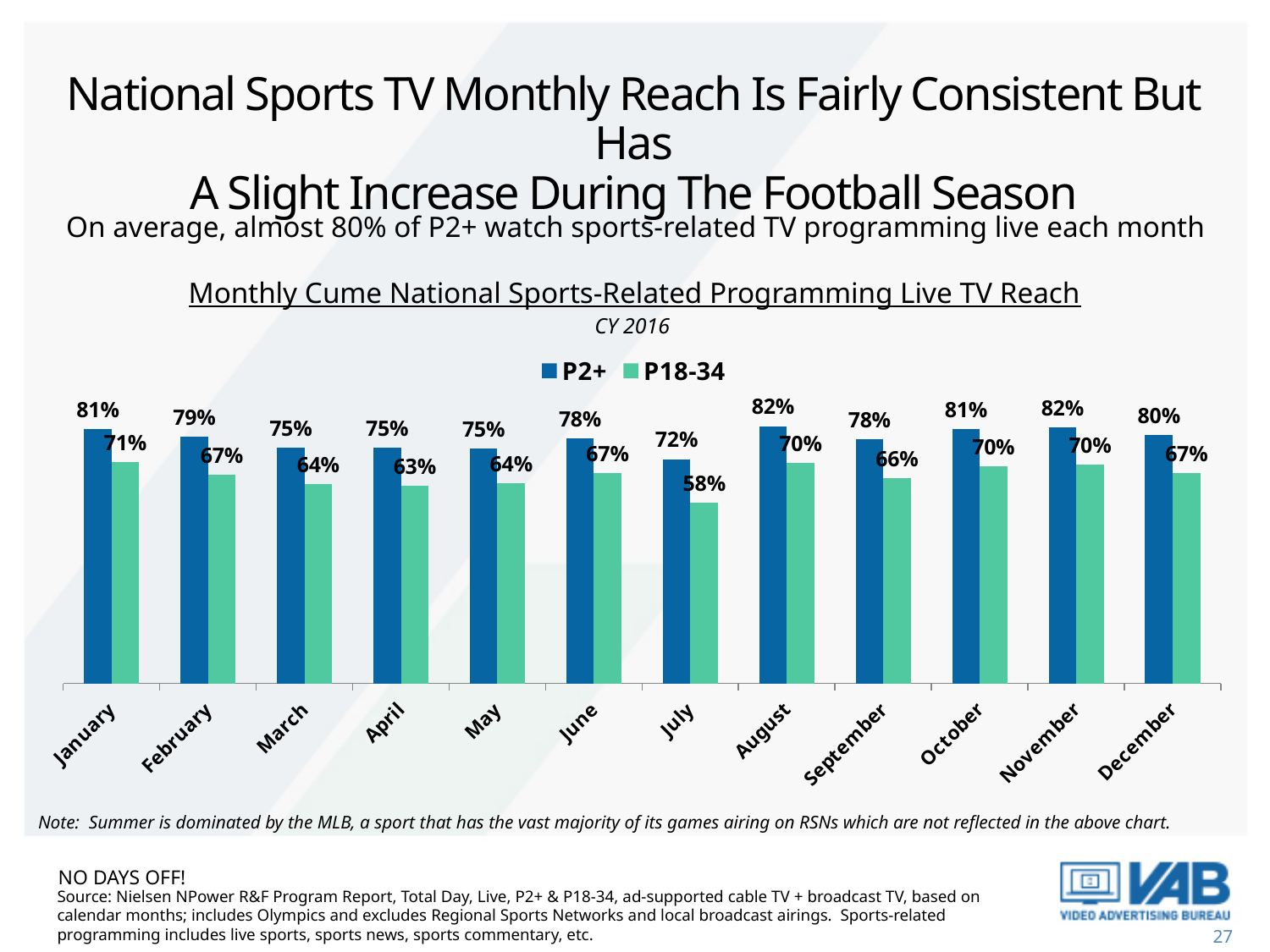
Which month has the lowest P2+ value? July How many months are shown on the x axis? 12 What kind of chart is shown on the slide? Bar chart What is the P2+ value for September? 78% What is the difference between the P2+ values for November and March? 7% What year does the chart subtitle say the data covers? CY 2016 What is the P2+ value for January? 81% What is the P18-34 value for July? 58% Which is larger, the P18-34 value for August or the P18-34 value for December? August Which month has the lowest P18-34 value? July How many series does the legend list? 2 What is the difference between the P2+ and P18-34 values for July? 14%